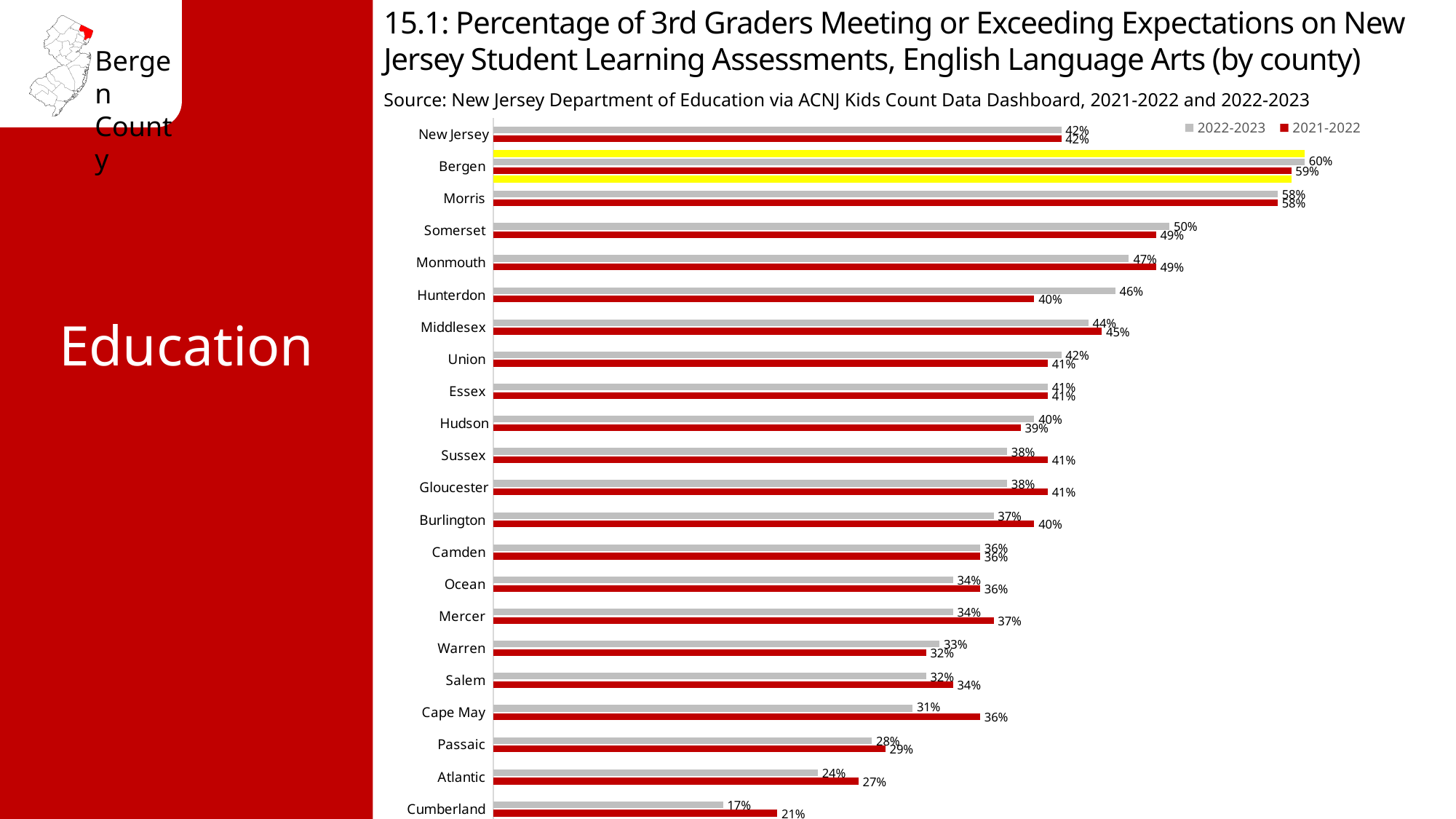
What is the 2022-2023 value for Cumberland? 17% Which county has the highest 2022-2023 value? Bergen Which series is shown in red in the legend? 2021-2022 Which is larger for Cape May: the 2022-2023 value or the 2021-2022 value? 2021-2022 What is the difference between Bergen's 2022-2023 value and New Jersey's 2022-2023 value? 18% What is the difference between Hunterdon's 2022-2023 value and its 2021-2022 value? 6% What is the 2022-2023 value for Bergen? 60% What type of chart is shown on the slide? bar chart Which county has the lowest 2021-2022 value? Cumberland How many categories (counties plus New Jersey) are plotted on the chart? 22 What is the 2021-2022 value for Hunterdon? 40% How many series does the legend list? 2